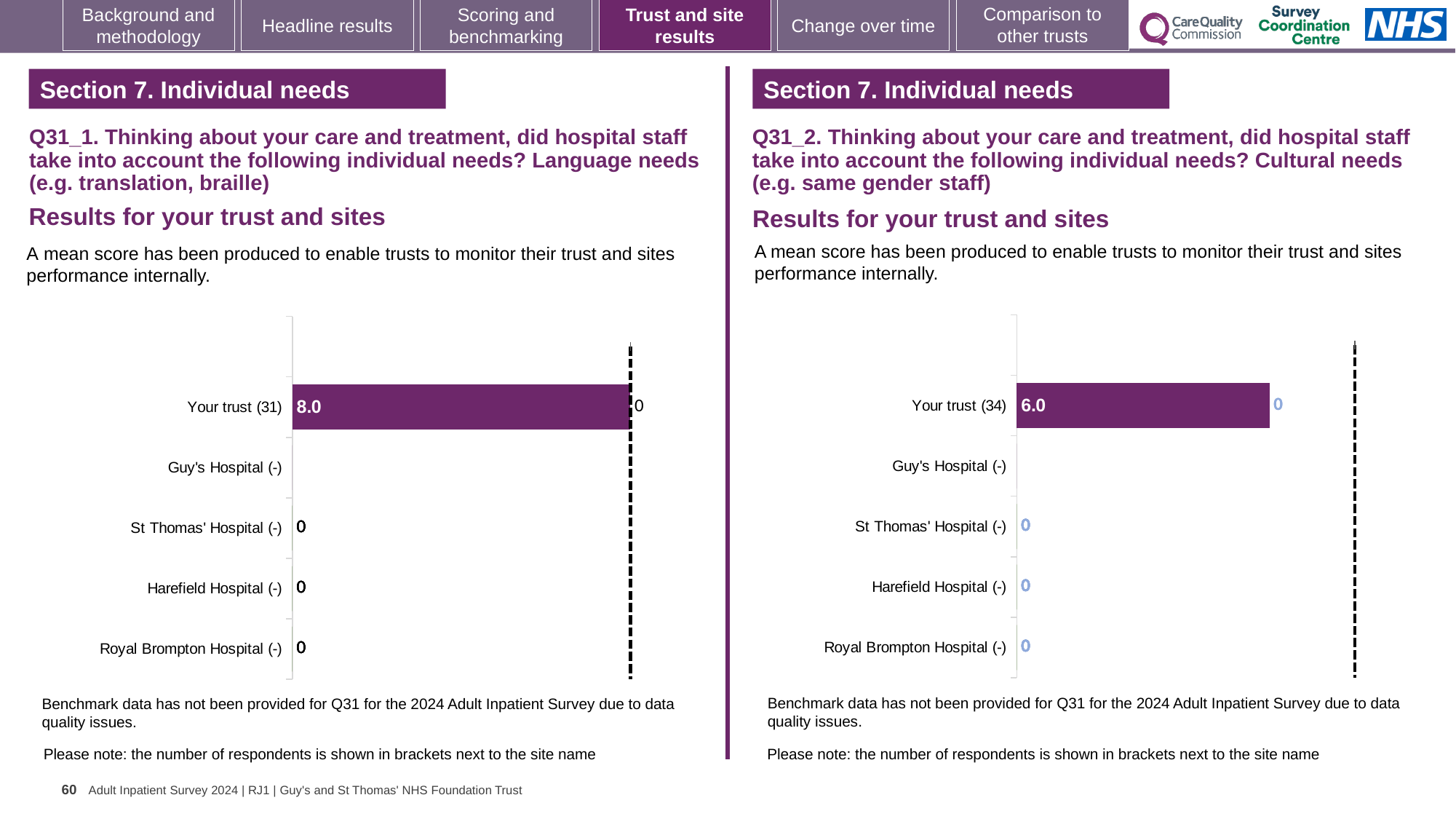
On the right chart (Q31_2), how many respondents are shown in brackets next to Your trust? 34 On the left chart (Q31_1), how many respondents are shown in brackets next to Your trust? 31 What is the difference between the Your trust score on the left chart (Q31_1) and the Your trust score on the right chart (Q31_2)? 2.0 What kind of chart is used on the right side of the slide for Q31_2? Bar chart Which is larger: the Your trust score on the left chart (Q31_1) or the Your trust score on the right chart (Q31_2)? Left chart (Q31_1), 8.0 How many categories are listed on the right chart (Q31_2)? 5 How many categories are listed on the left chart (Q31_1)? 5 What kind of chart is used on the left side of the slide for Q31_1? Bar chart On the left chart (Q31_1, Language needs), what is the mean score for Your trust? 8.0 On the right chart (Q31_2), which category has the highest mean score? Your trust (34) On the right chart (Q31_2, Cultural needs), what is the mean score for Your trust? 6.0 On the left chart (Q31_1), which category has the highest mean score? Your trust (31)